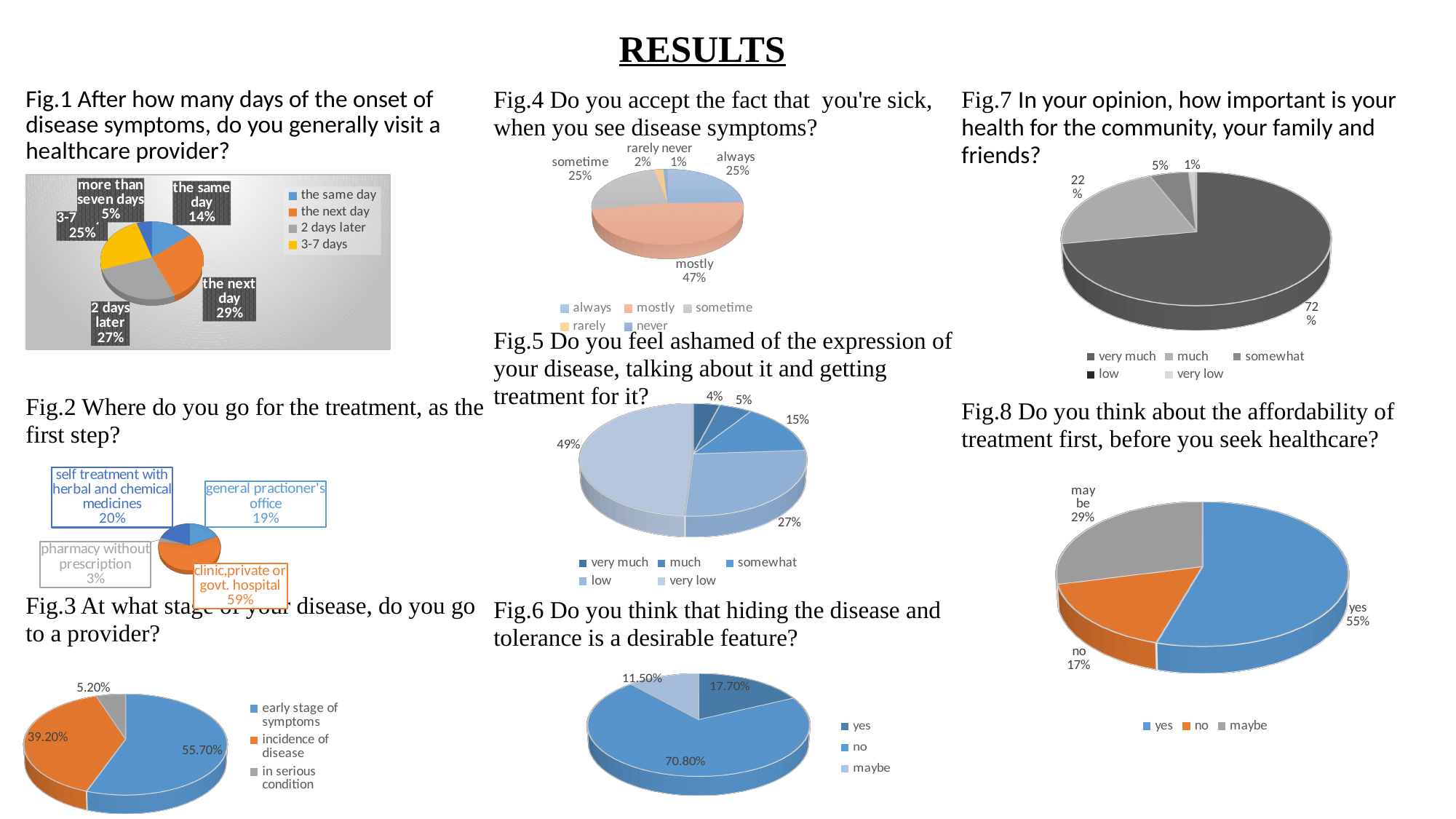
In Fig.4, how many categories does the legend list? 5 In Fig.3, what percentage of respondents go to a provider at the early stage of symptoms? 55.70% In Fig.1, what percentage of respondents visit a healthcare provider the next day? 29% In Fig.3, which is larger: incidence of disease or in serious condition? incidence of disease In Fig.5, which category has the largest share? very low In Fig.7, what percentage of respondents answered 'very much'? 72% In Fig.8, what is the difference between the 'yes' share and the 'no' share? 38% In Fig.1, which category has the smallest share of the pie? more than seven days In Fig.4, what percentage of respondents answered 'mostly'? 47% In Fig.6, what percentage of respondents answered 'no'? 70.80% In Fig.2, what percentage of respondents go to a clinic, private or govt. hospital as the first step? 59% In Fig.2, what is the difference between the share for self treatment with herbal and chemical medicines and the share for general practioner's office? 1%